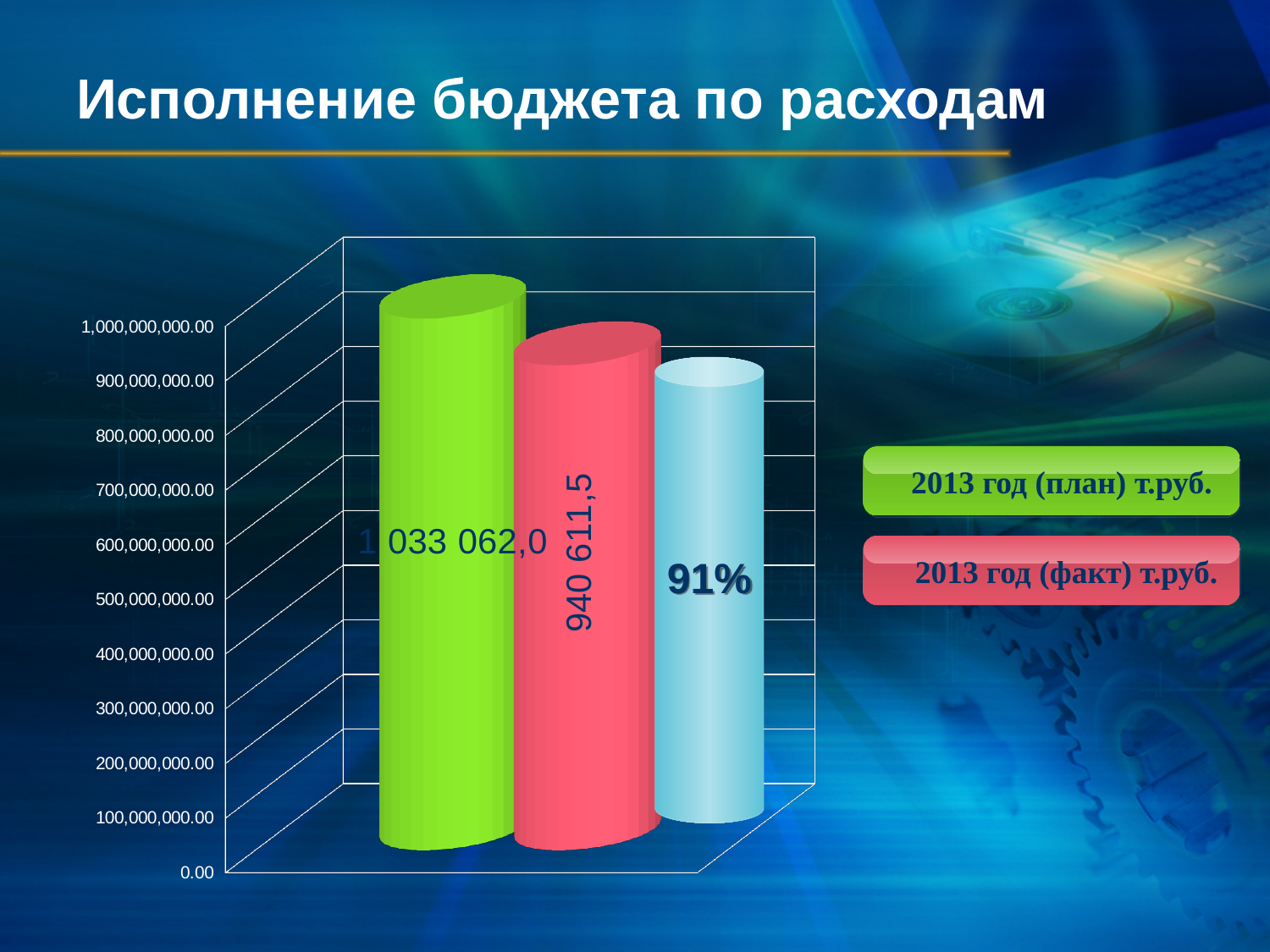
How many entries does the legend list? 2 What colour is the legend entry for 2013 год (план) т.руб.? green How many bars are plotted in the chart? 3 What value is printed on the bar for 2013 год (план) т.руб.? 1 033 062,0 Which is larger, the 2013 план value or the 2013 факт value? 2013 год (план) т.руб. What value is printed on the bar for 2013 год (факт) т.руб.? 940 611,5 What is the title of the slide's chart? Исполнение бюджета по расходам What kind of chart is shown on the slide? bar chart What percentage is printed on the light blue bar? 91% What is the difference between the 2013 план value (1 033 062,0) and the 2013 факт value (940 611,5)? 92 450,5 Is the red 2013 факт bar greater or less than 1,000,000,000.00 on the axis? less